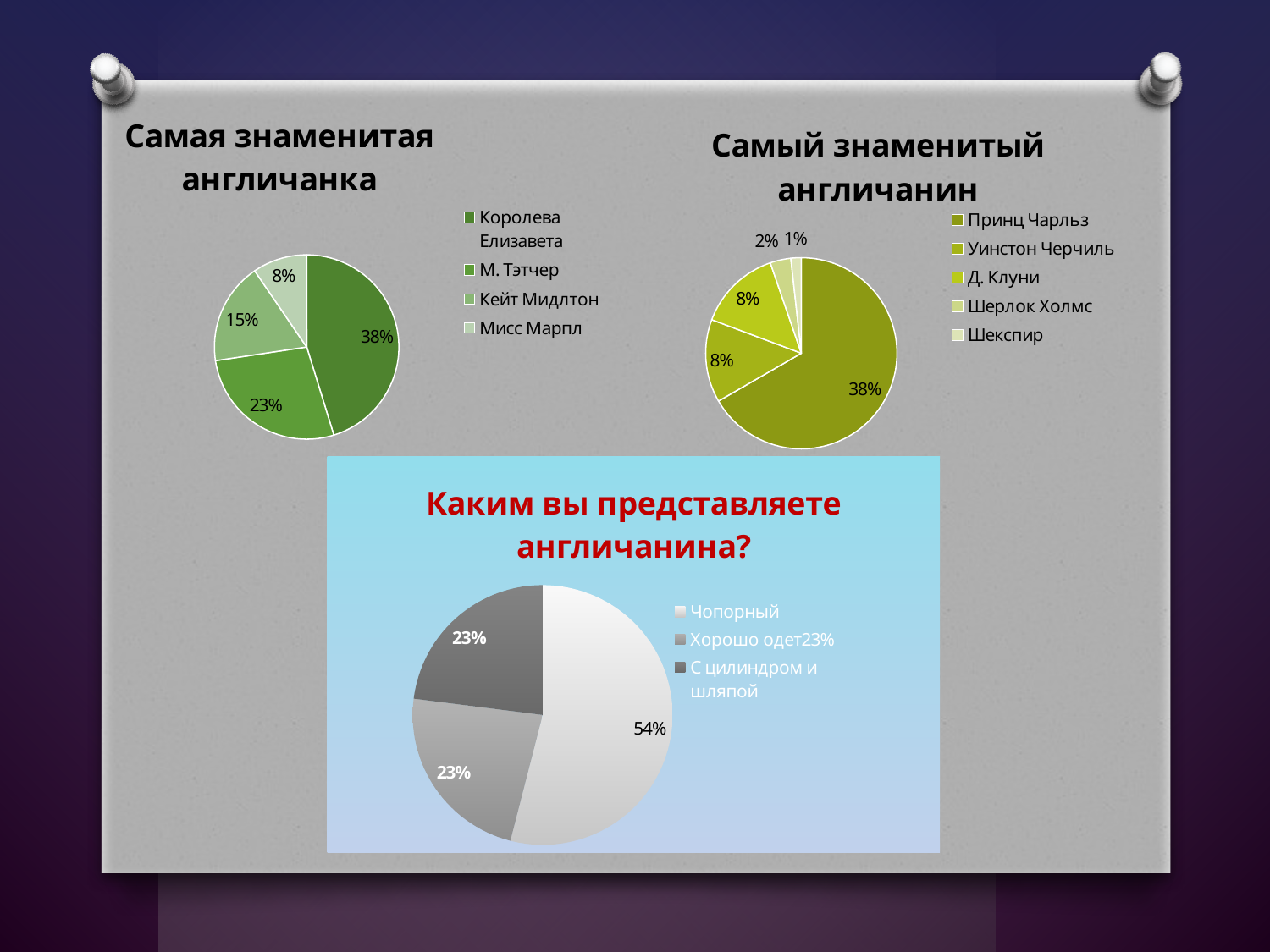
In the chart titled "Самая знаменитая англичанка", what percentage is shown for Кейт Мидлтон? 15% In the chart titled "Каким вы представляете англичанина?", what percentage is shown for Чопорный? 54% In the chart titled "Самый знаменитый англичанин", what percentage is shown for Шекспир? 1% In the chart titled "Самый знаменитый англичанин", which category has the smallest share? Шекспир In the chart titled "Самая знаменитая англичанка", how many entries does the legend list? 4 In the chart titled "Каким вы представляете англичанина?", what is the difference between the share for Чопорный and the share for С цилиндром и шляпой? 31% In the chart titled "Самый знаменитый англичанин", how many entries does the legend list? 5 In the chart titled "Самая знаменитая англичанка", which category has the largest share? Королева Елизавета In the chart titled "Самая знаменитая англичанка", what percentage is shown for Королева Елизавета? 38% In the chart titled "Каким вы представляете англичанина?", which category has the largest share? Чопорный What kind of chart is the chart titled "Каким вы представляете англичанина?"? Pie chart In the chart titled "Самый знаменитый англичанин", what percentage is shown for Принц Чарльз? 38%